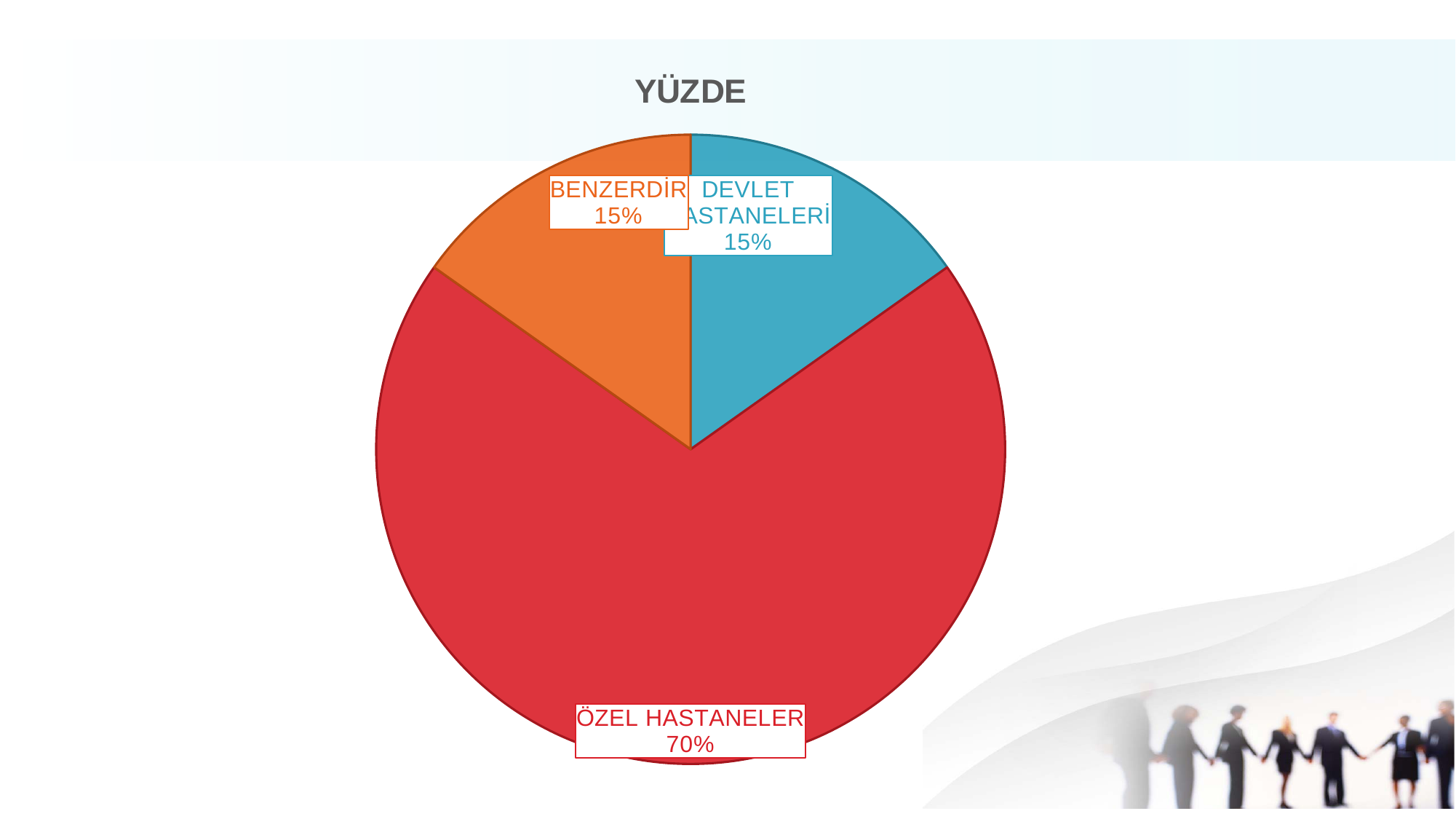
How many slices does the pie chart have? 3 What percentage is shown for DEVLET HASTANELERİ? 15% Do DEVLET HASTANELERİ and BENZERDİR have the same percentage? Yes What percentage is shown for BENZERDİR? 15% What share of the pie does ÖZEL HASTANELER take? 70% What colour is the ÖZEL HASTANELER slice? Red What type of chart is shown on the slide? Pie chart What is the title of the chart? YÜZDE What percentage is shown for ÖZEL HASTANELER? 70% What is the difference in percentage points between ÖZEL HASTANELER and BENZERDİR? 55 Which slice of the pie is the largest? ÖZEL HASTANELER Which is larger, ÖZEL HASTANELER or DEVLET HASTANELERİ? ÖZEL HASTANELER